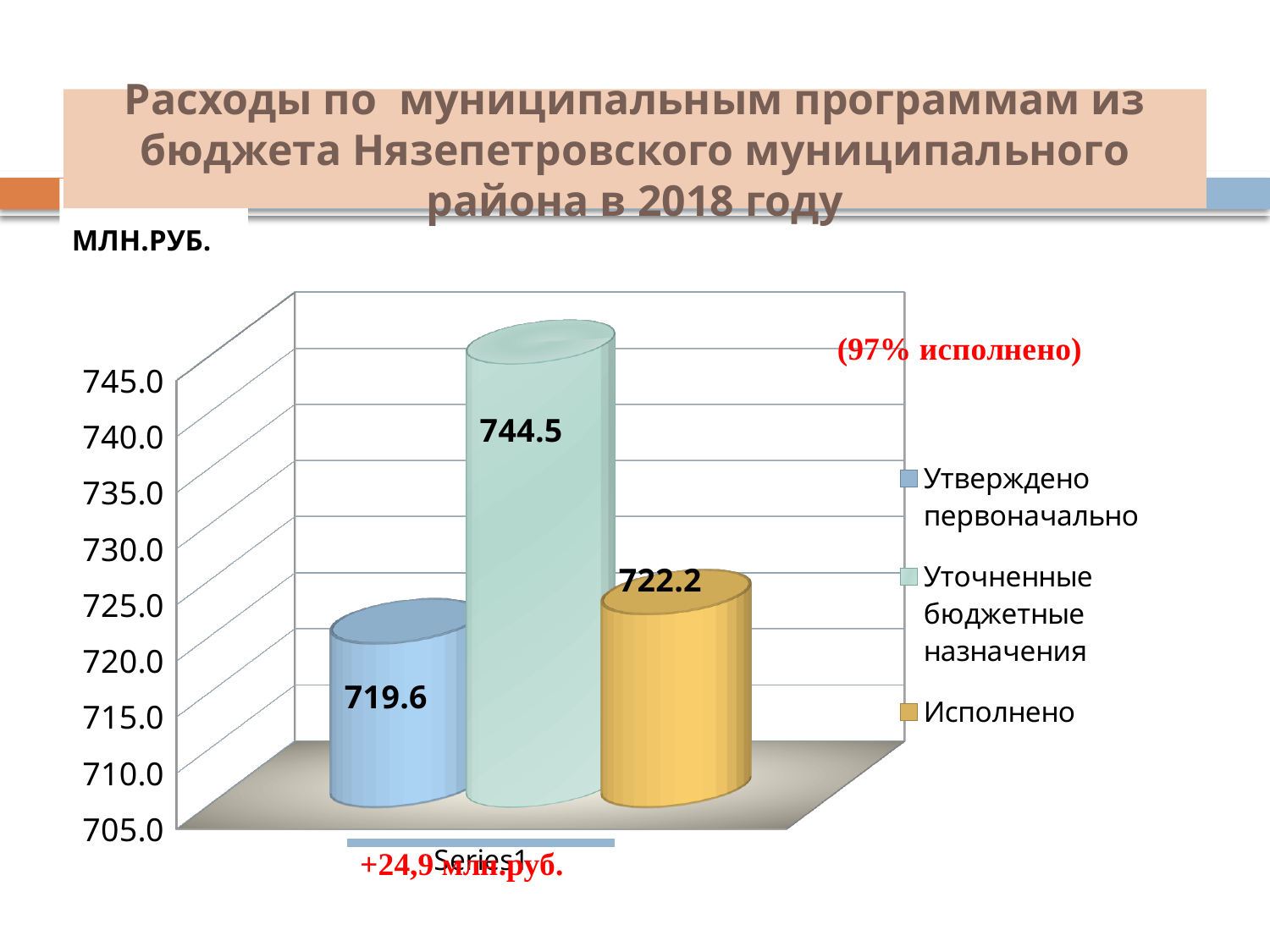
Which is larger, Исполнено or Утверждено первоначально? Исполнено What unit is indicated above the chart? МЛН.РУБ. What is the value for Утверждено первоначально? 719.6 What kind of chart is shown on the slide? bar chart What is the difference between Исполнено and Утверждено первоначально? 2.6 What is the difference between Уточненные бюджетные назначения and Исполнено? 22.3 How many series does the legend list? 3 What is the value for Уточненные бюджетные назначения? 744.5 What is the value for Исполнено? 722.2 Which series has the highest value? Уточненные бюджетные назначения Is the value for Уточненные бюджетные назначения greater or less than 740.0? greater Which series has the lowest value? Утверждено первоначально